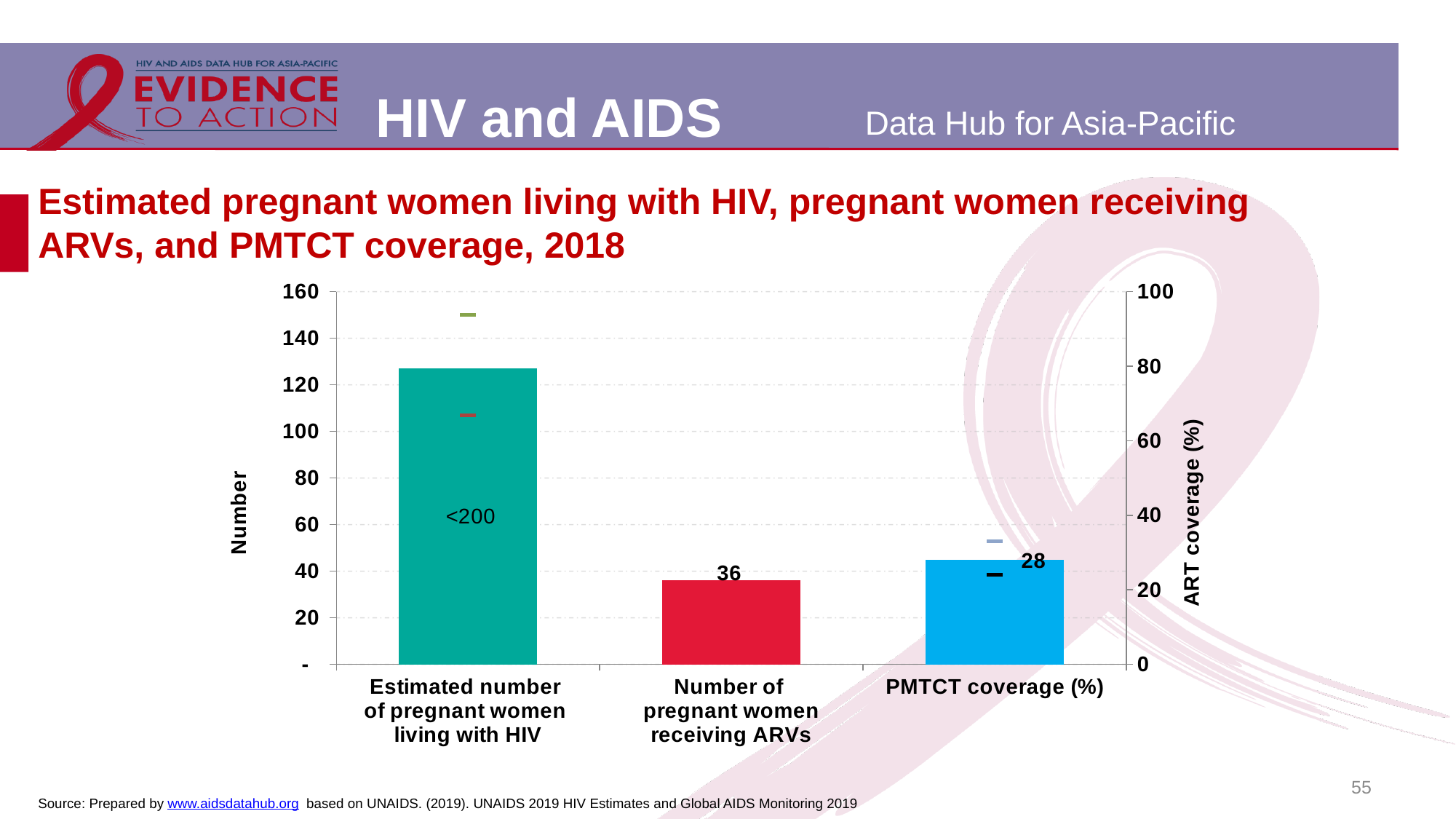
Is the bar for the number of pregnant women receiving ARVs greater or less than 60 on the left axis? less What is the label of the right-hand vertical axis? ART coverage (%) What year does the chart title refer to? 2018 What kind of chart is shown on the slide? Bar chart Which category has the tallest bar? Estimated number of pregnant women living with HIV What label is printed on the bar for the estimated number of pregnant women living with HIV? <200 Which category has the shortest bar? Number of pregnant women receiving ARVs What is the value shown for the number of pregnant women receiving ARVs? 36 How many categories are shown on the x axis? 3 Is the bar for the estimated number of pregnant women living with HIV greater or less than 100 on the left axis? greater What is the value shown for PMTCT coverage (%)? 28 Which is larger: the bar for the estimated number of pregnant women living with HIV or the bar for the number of pregnant women receiving ARVs? Estimated number of pregnant women living with HIV